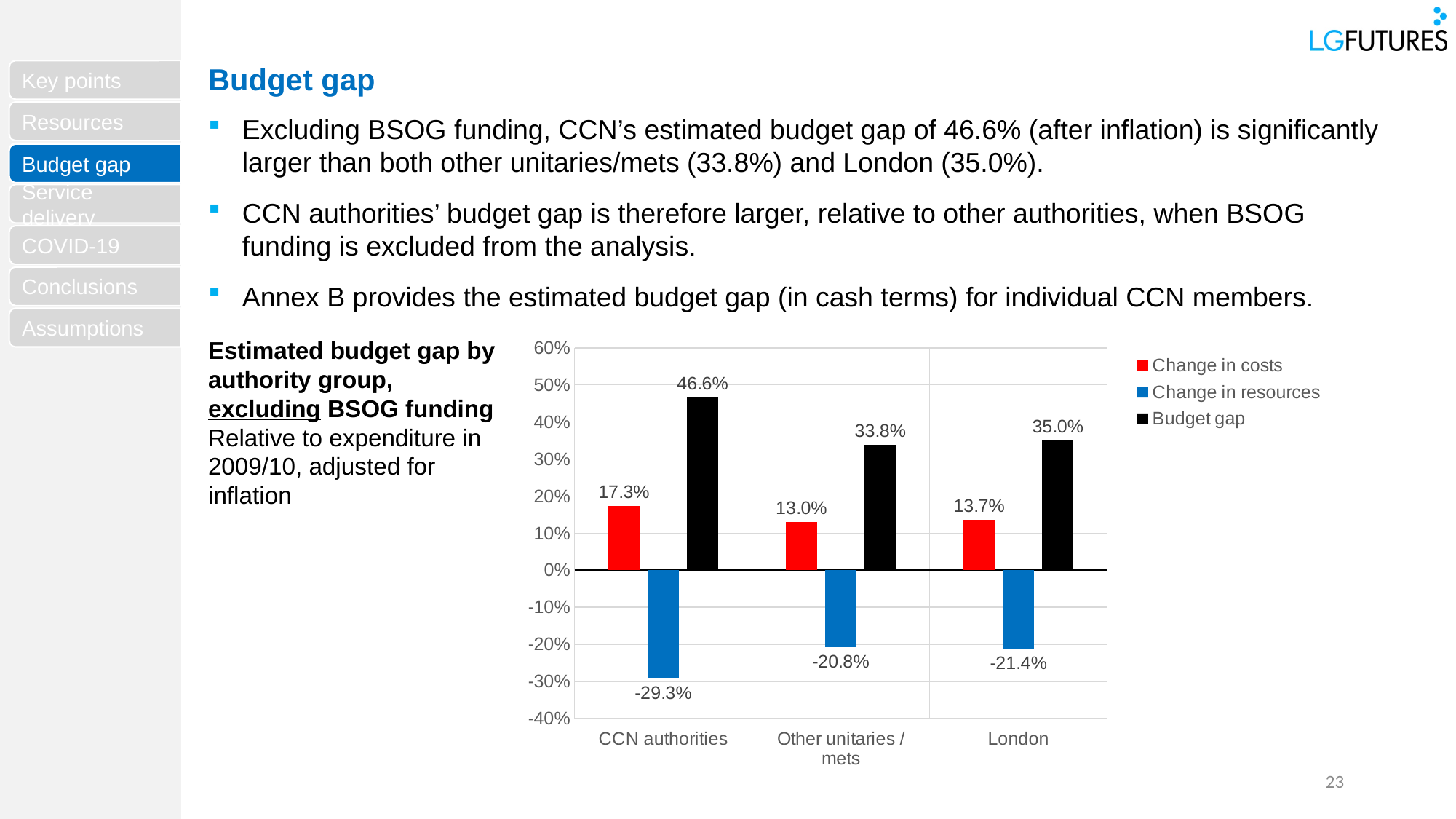
What kind of chart is shown on the slide? Bar chart What is the Change in costs value for London? 13.7% Which authority group has the highest Budget gap? CCN authorities Which authority group has the lowest Change in costs? Other unitaries / mets What is the Change in resources value for CCN authorities? -29.3% What is the difference between the Budget gap for CCN authorities and for Other unitaries / mets? 12.8 percentage points What is the Budget gap value for CCN authorities? 46.6% Which colour represents the Change in resources series in the legend? Blue How many authority groups are shown on the x axis? 3 How many series does the legend list? 3 Which is larger, the Budget gap for London or for Other unitaries / mets? London What is the Change in resources value for Other unitaries / mets? -20.8%